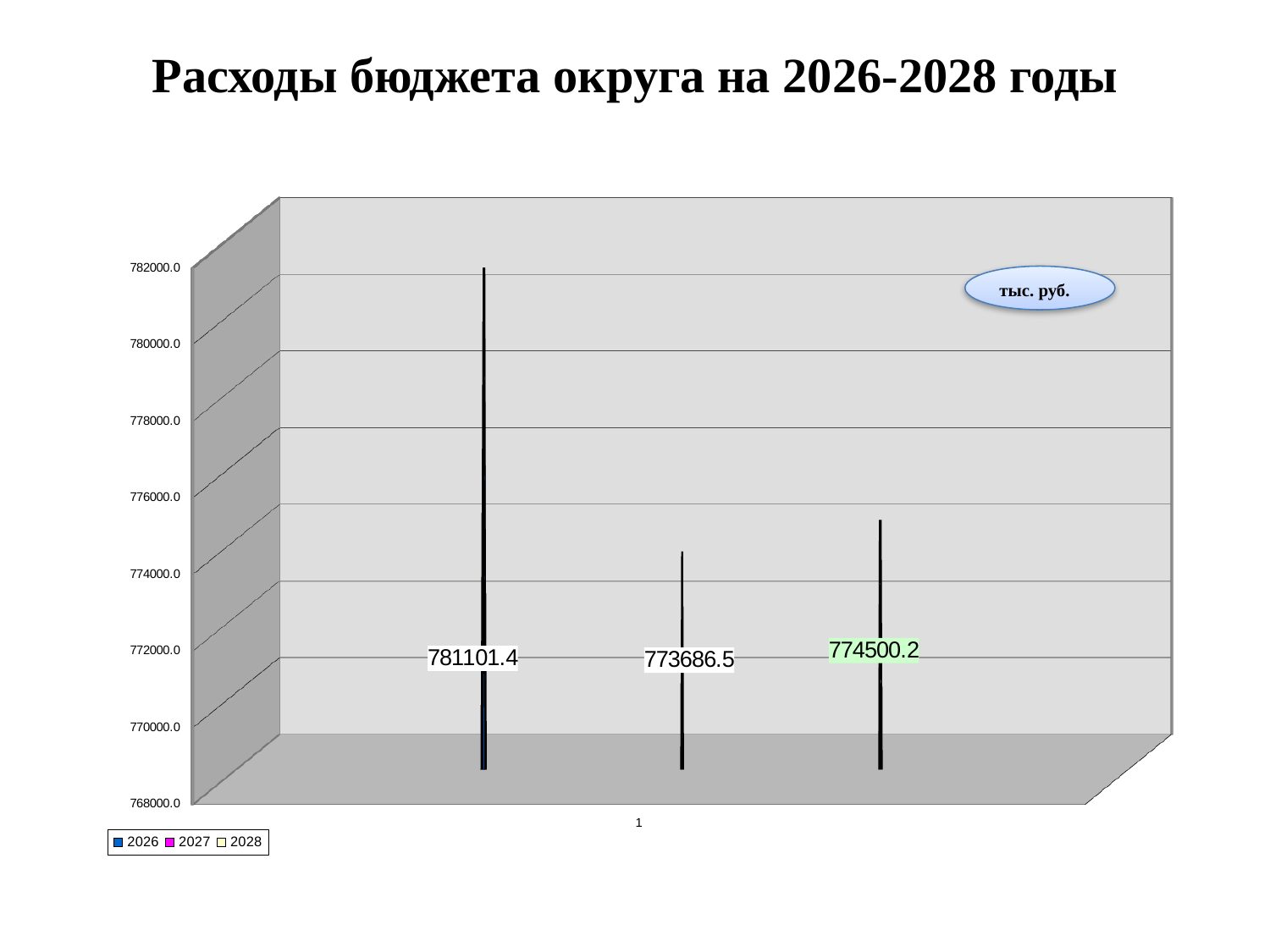
How many series does the legend list? 3 What is the value for 2026? 781101.4 What is the difference between the values for 2028 and 2027? 813.7 Is the value for 2026 greater or less than 780000.0? greater What unit is shown in the oval label on the chart? тыс. руб. Which is larger, the value for 2026 or the value for 2028? 2026 What is the value for 2027? 773686.5 What is the value for 2028? 774500.2 What kind of chart is shown on the slide? bar chart What is the difference between the values for 2026 and 2027? 7414.9 Which year has the highest value? 2026 Which year has the lowest value? 2027